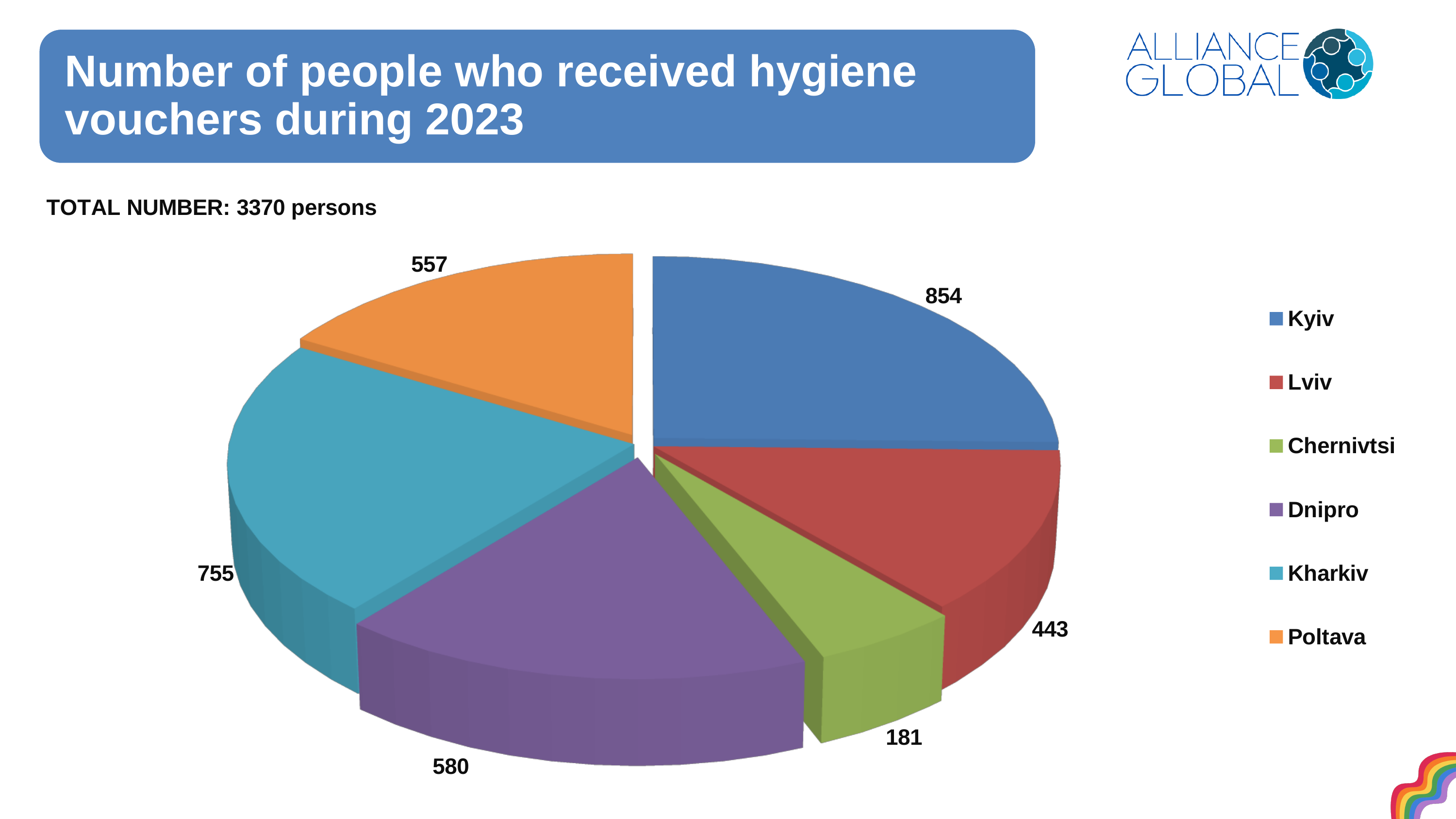
What is the value shown for Chernivtsi? 181 What kind of chart is shown on the slide? pie chart How many cities are shown in the pie chart? 6 What is the value shown for Poltava? 557 Which city has the largest slice of the pie? Kyiv What is the difference between the values for Kyiv and Lviv? 411 What is the value shown for Kharkiv? 755 How many people in Kyiv received hygiene vouchers during 2023? 854 What is the total number of persons stated on the slide? 3370 persons Which colour represents Kharkiv in the legend? teal (light blue) Which is larger, the value for Dnipro or the value for Poltava? Dnipro Which city has the smallest slice of the pie? Chernivtsi